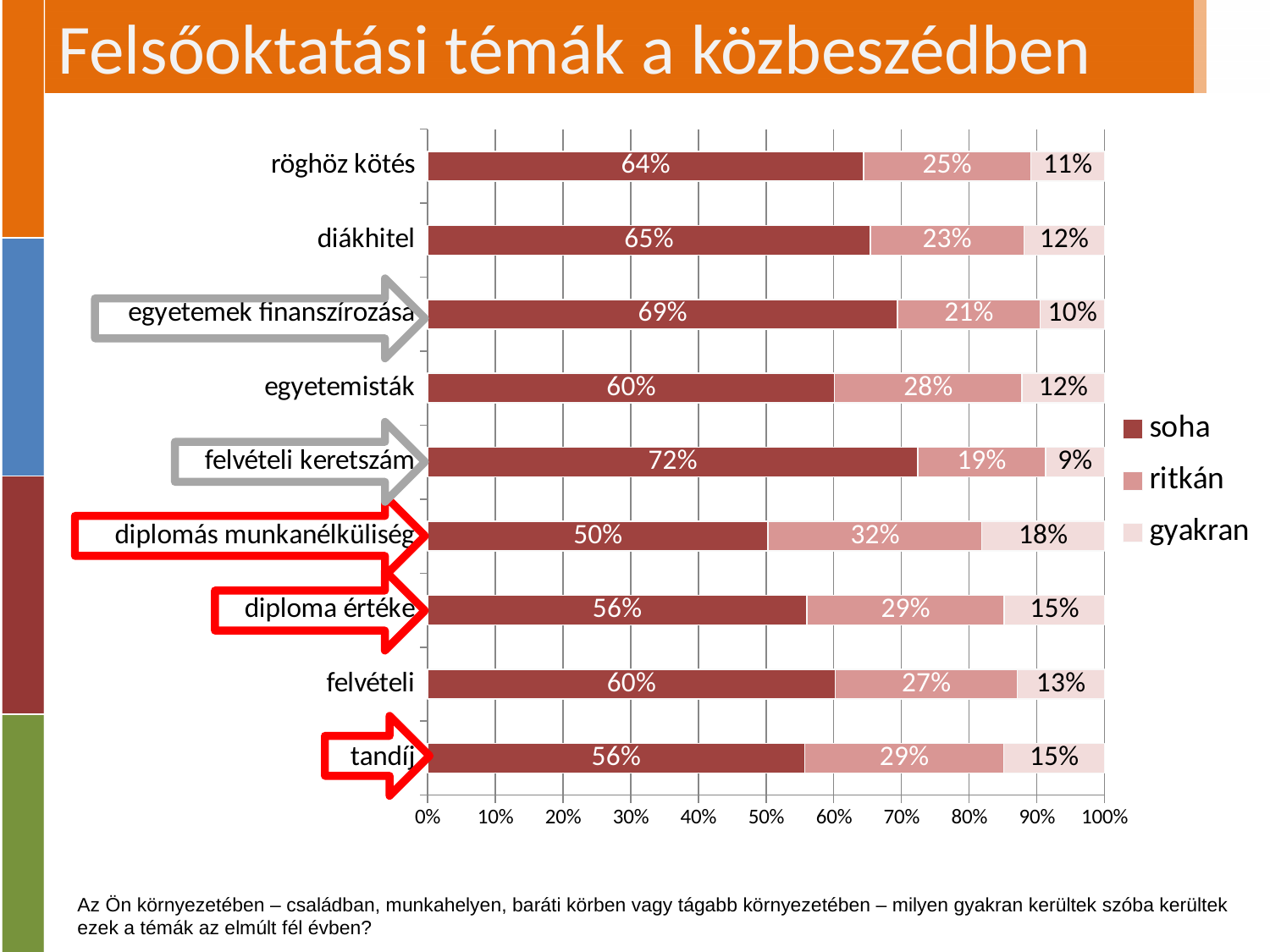
How many categories are shown on the chart? 9 How many series does the legend list? 3 What is the 'ritkán' value for 'egyetemisták'? 28% What is the total of the stacked bar for 'tandíj'? 100% What is the difference between the 'soha' values for 'egyetemek finanszírozása' and 'diákhitel'? 4% What is the 'gyakran' value for 'diplomás munkanélküliség'? 18% Which is larger: the 'ritkán' value for 'röghöz kötés' or for 'diákhitel'? röghöz kötés What is the 'soha' value for 'felvételi keretszám'? 72% What kind of chart is shown on the slide? stacked bar chart Which category has the lowest 'soha' value? diplomás munkanélküliség Which category has the lowest 'gyakran' value? felvételi keretszám Which category has the highest 'soha' value? felvételi keretszám